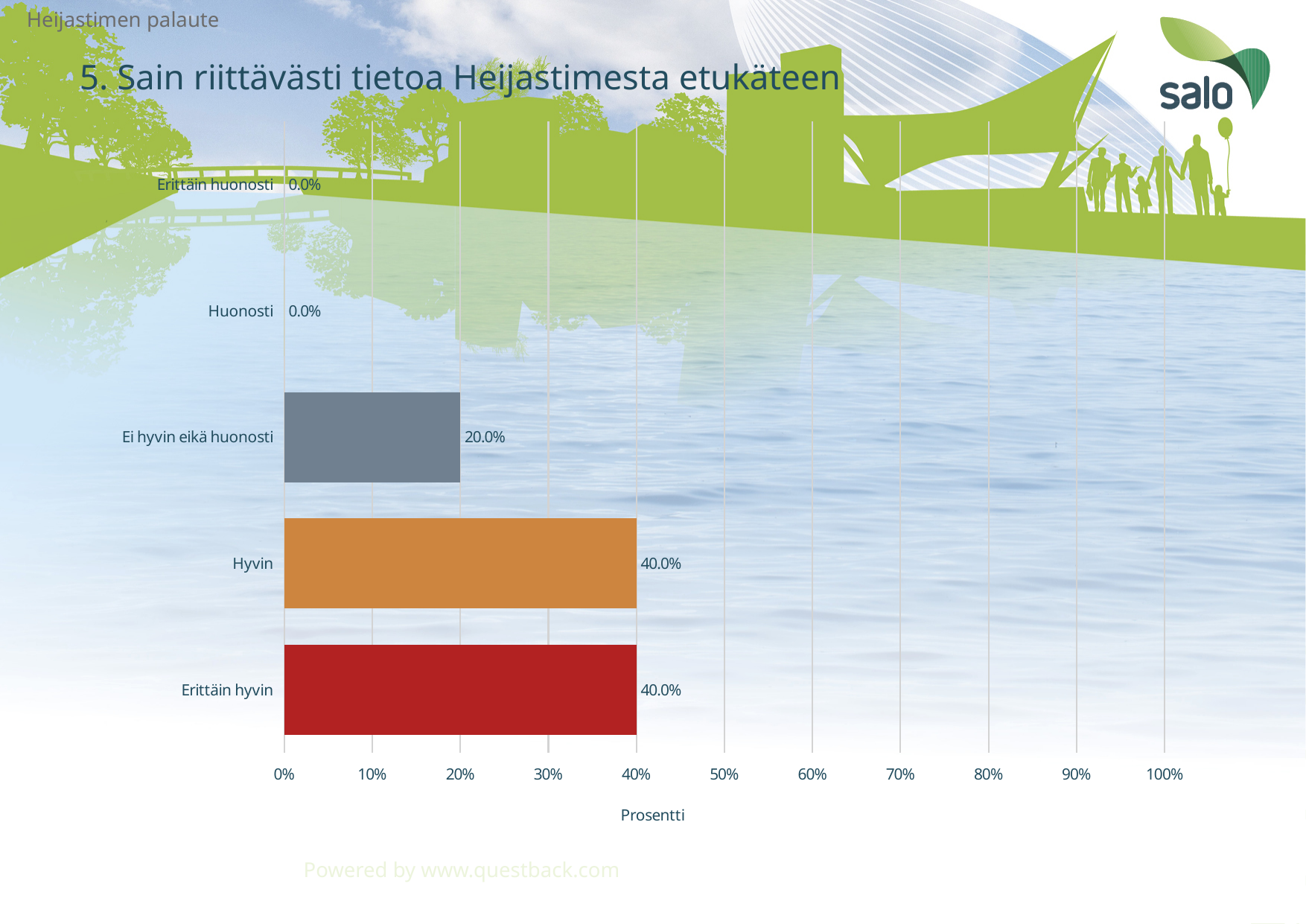
What kind of chart is shown on the slide? bar chart How many categories are shown on the chart? 5 Which category has the lowest non-zero value? Ei hyvin eikä huonosti What is the label of the horizontal axis? Prosentti Which is larger, the value for "Erittäin hyvin" or the value for "Ei hyvin eikä huonosti"? Erittäin hyvin What is the value for "Hyvin"? 40.0% Is the value for "Ei hyvin eikä huonosti" greater or less than 30%? less What is the value for "Huonosti"? 0.0% What is the difference between the values for "Hyvin" and "Ei hyvin eikä huonosti"? 20.0% What is the value for "Erittäin huonosti"? 0.0% What is the value for "Ei hyvin eikä huonosti"? 20.0% What is the title of the chart? 5. Sain riittävästi tietoa Heijastimesta etukäteen